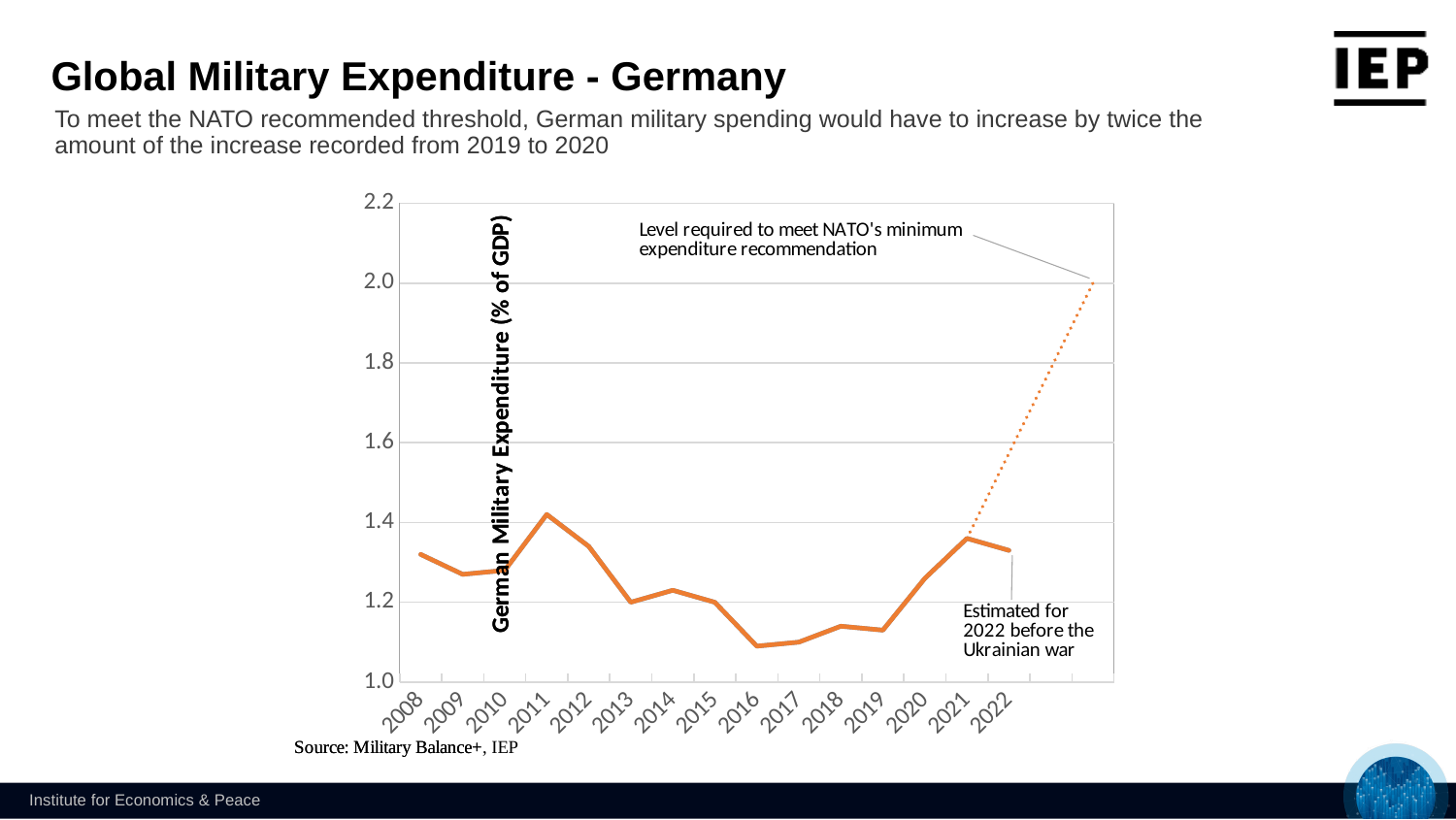
Which is larger, the value for 2008 or the value for 2016? 2008 Do the values rise or fall from 2011 to 2016? fall Is the value for 2016 greater or less than 1.2? less Is the value for 2011 greater or less than 1.4? greater Is the value for 2021 greater or less than 1.4? less What level of GDP is marked as required to meet NATO's minimum expenditure recommendation? 2.0 Which year has the highest German military expenditure as a share of GDP among the solid-line data points? 2011 What is the label of the y axis? German Military Expenditure (% of GDP) What kind of chart is shown on the slide? line chart How many years are shown on the x axis of the chart? 15 What is the source cited below the chart? Military Balance+, IEP